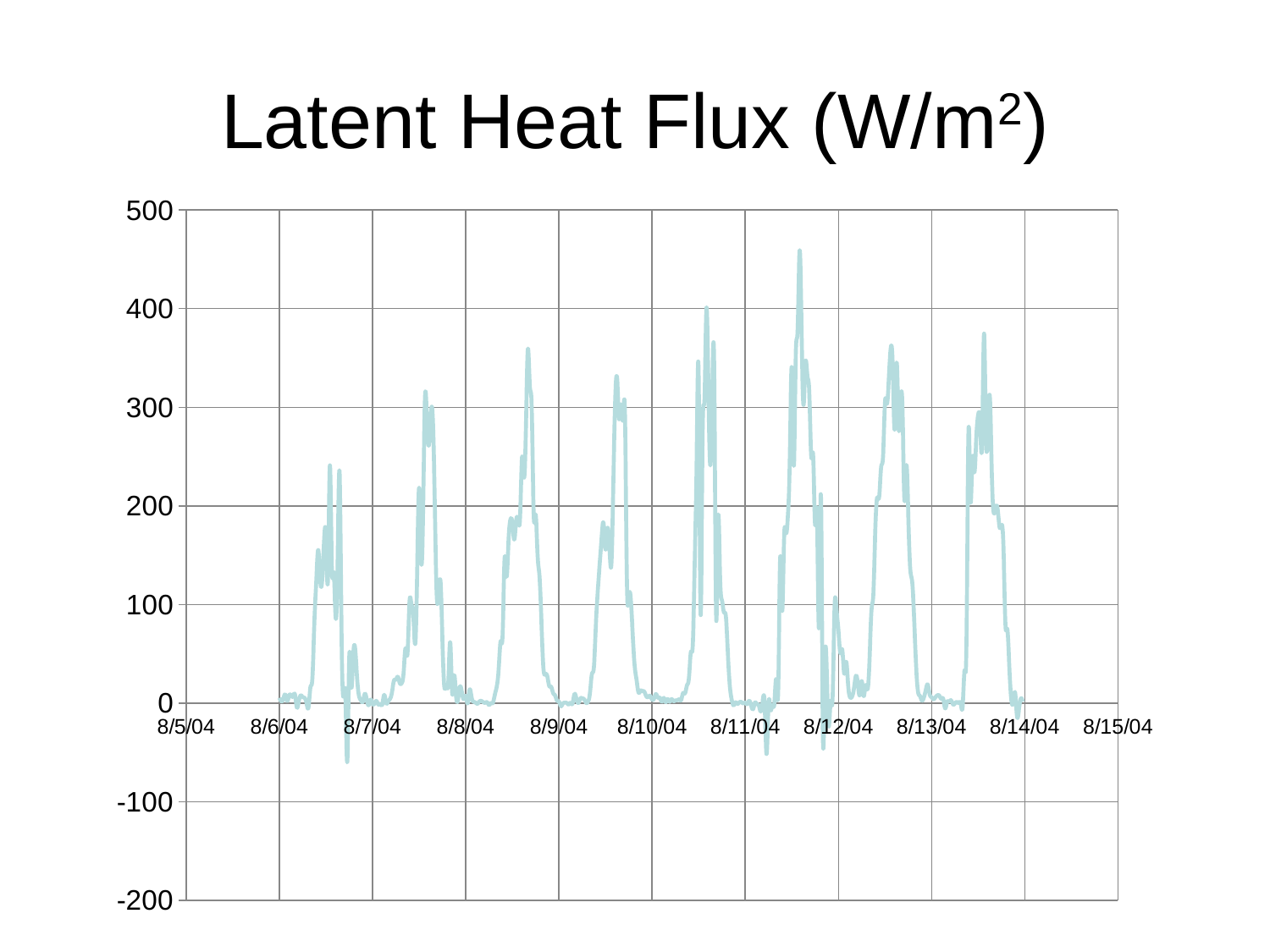
Which daily peak is higher: the one between 8/6/04 and 8/7/04 or the one between 8/11/04 and 8/12/04? 8/11/04 and 8/12/04 Is the peak of the latent heat flux between 8/12/04 and 8/13/04 greater or less than 400? less What is the lowest value shown on the vertical axis? -200 Is the peak of the latent heat flux between 8/6/04 and 8/7/04 greater or less than 300? less Between which two date labels does the latent heat flux reach its highest peak? 8/11/04 and 8/12/04 What is the title of the chart? Latent Heat Flux (W/m2) Does the latent heat flux ever drop below 0 on the chart? yes What is the highest value shown on the vertical axis? 500 How many date labels are shown along the horizontal axis? 11 What kind of chart is shown on the slide? line chart